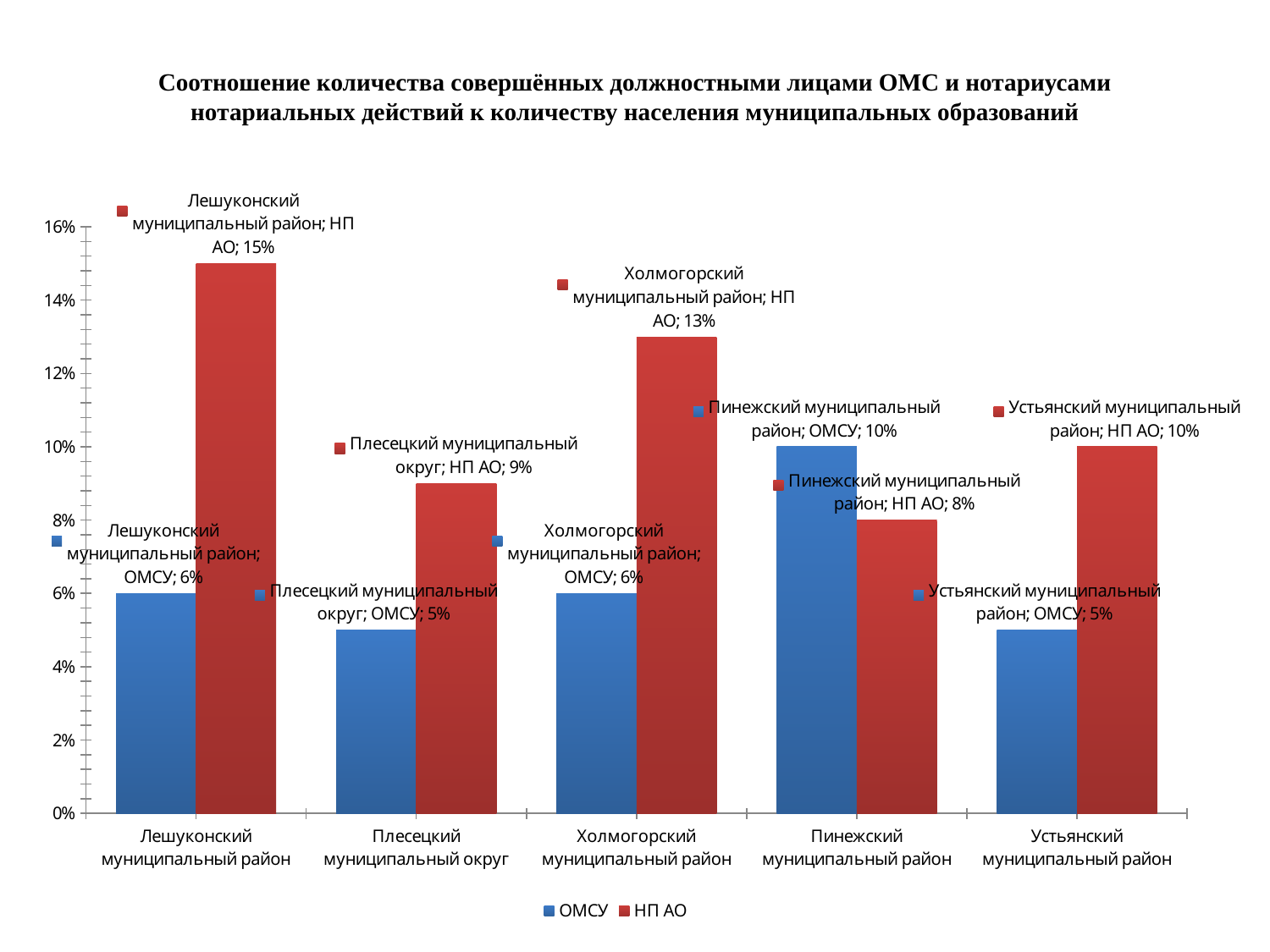
What is the difference between the НП АО and ОМСУ values in Холмогорский муниципальный район? 7% In Пинежский муниципальный район, which is larger: ОМСУ or НП АО? ОМСУ What is the value for НП АО in Лешуконский муниципальный район? 15% What is the value for НП АО in Плесецкий муниципальный округ? 9% How many categories are shown on the x axis? 5 How many series does the legend list? 2 Which category has the lowest value for НП АО? Пинежский муниципальный район What is the value for ОМСУ in Пинежский муниципальный район? 10% Which category has the highest value for НП АО? Лешуконский муниципальный район What kind of chart is shown on the slide? bar chart Which category has the highest value for ОМСУ? Пинежский муниципальный район Is the value for НП АО in Устьянский муниципальный район greater or less than 8%? greater